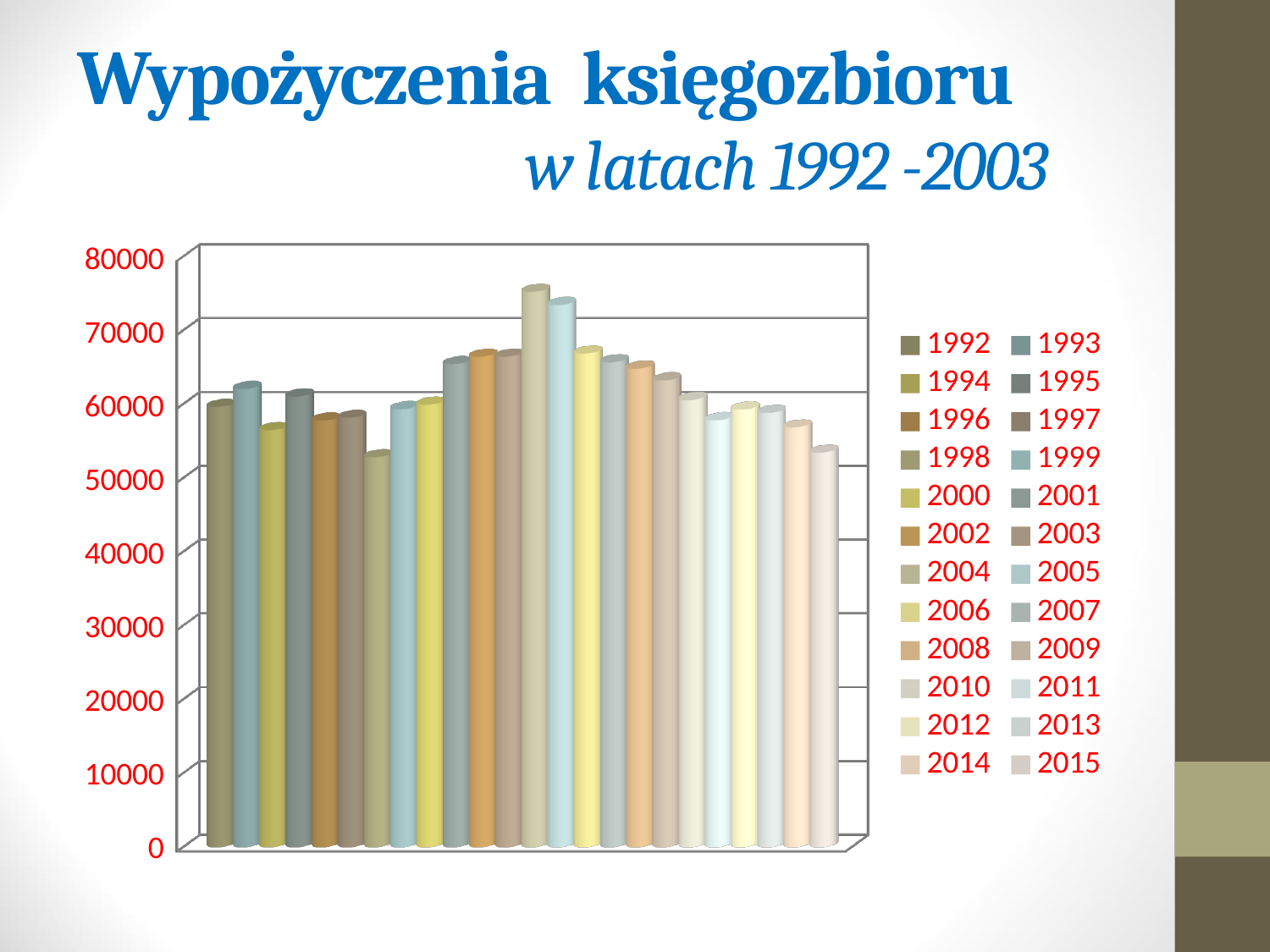
Which is larger, the value for 1993 or the value for 1994? 1993 How many entries does the legend list? 24 Is the value for 2004 greater or less than 70000? greater Which is larger, the value for 2004 or the value for 1998? 2004 Is the value for 2015 greater or less than 60000? less Do the values rise or fall from 2004 to 2015? fall What is the title of the slide containing the chart? Wypożyczenia księgozbioru w latach 1992 -2003 How many bars are plotted in the chart? 24 Which year has the highest bar? 2004 Is the value for 1998 greater or less than 60000? less What kind of chart is shown on the slide? bar chart